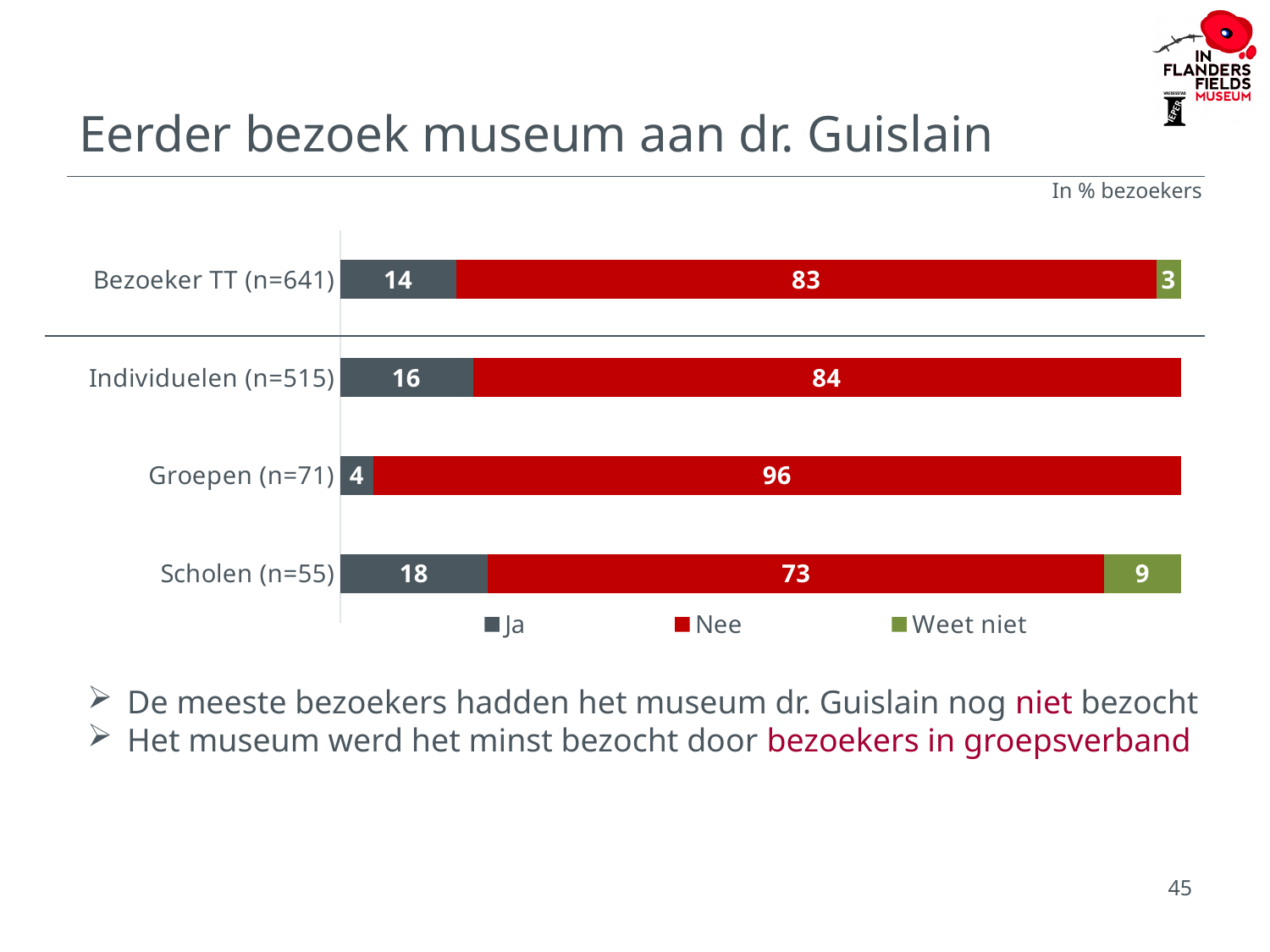
Which category has the lowest 'Ja' value? Groepen (n=71) What is the 'Nee' value for Groepen (n=71)? 96 How many series does the legend list? 3 What is the 'Weet niet' value for Scholen (n=55)? 9 How many categories are shown in the chart? 4 Which category has the highest 'Nee' value? Groepen (n=71) What kind of chart is shown on the slide? Stacked bar chart What is the total of the stacked bar for Scholen (n=55)? 100 What is the difference between the 'Ja' values for Scholen (n=55) and Individuelen (n=515)? 2 What is the title of the chart? Eerder bezoek museum aan dr. Guislain What is the 'Ja' value for Bezoeker TT (n=641)? 14 Which is larger: the 'Nee' value for Individuelen (n=515) or for Scholen (n=55)? Individuelen (n=515)